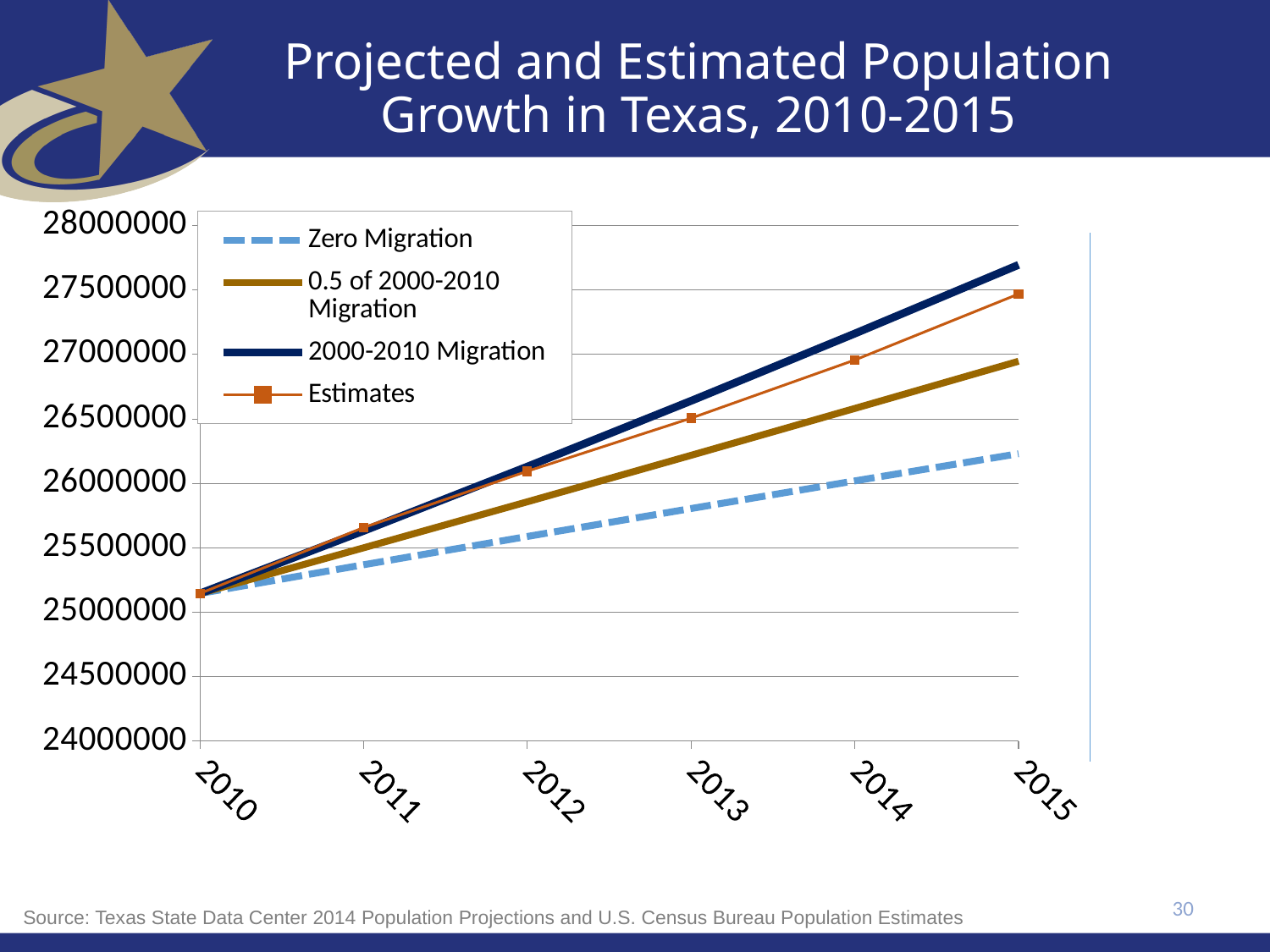
How many series does the legend list? 4 Is the value for Zero Migration in 2015 greater or less than 26500000? less Do the values for the Estimates series rise or fall from 2010 to 2015? Rise In 2015, which is larger: the Estimates value or the 0.5 of 2000-2010 Migration value? Estimates Is the value for 2000-2010 Migration in 2015 greater or less than 27500000? greater How many years are shown along the x axis? 6 Which series has the highest value in 2015? 2000-2010 Migration Is the value for Estimates in 2015 greater or less than 27000000? greater What kind of chart is shown on the slide? Line chart Which series is drawn as a dashed line? Zero Migration What is the title of the chart? Projected and Estimated Population Growth in Texas, 2010-2015 Which series has the lowest value in 2015? Zero Migration